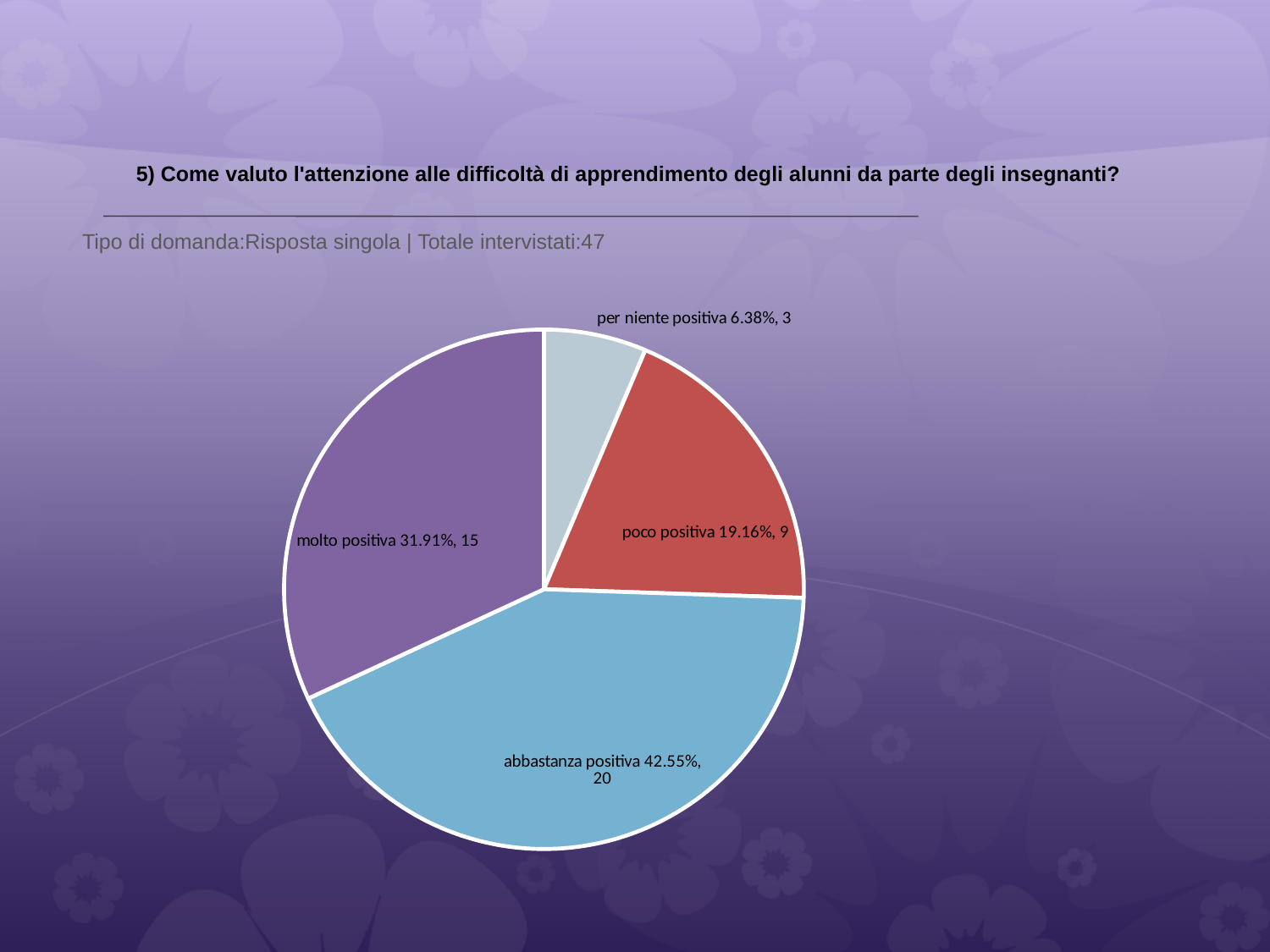
Which category has the smallest slice of the pie? per niente positiva What percentage share does the 'per niente positiva' slice have? 6.38% How many respondents answered 'molto positiva'? 15 What percentage share does the 'abbastanza positiva' slice have? 42.55% How many respondents answered 'poco positiva'? 9 What is the total number of respondents stated on the slide? 47 What is the difference in respondent count between 'abbastanza positiva' and 'molto positiva'? 5 What colour is the 'molto positiva' slice? purple How many slices does the pie chart have? 4 Which category has the largest slice of the pie? abbastanza positiva Which has more respondents, 'poco positiva' or 'per niente positiva'? poco positiva What kind of chart is shown on the slide? pie chart